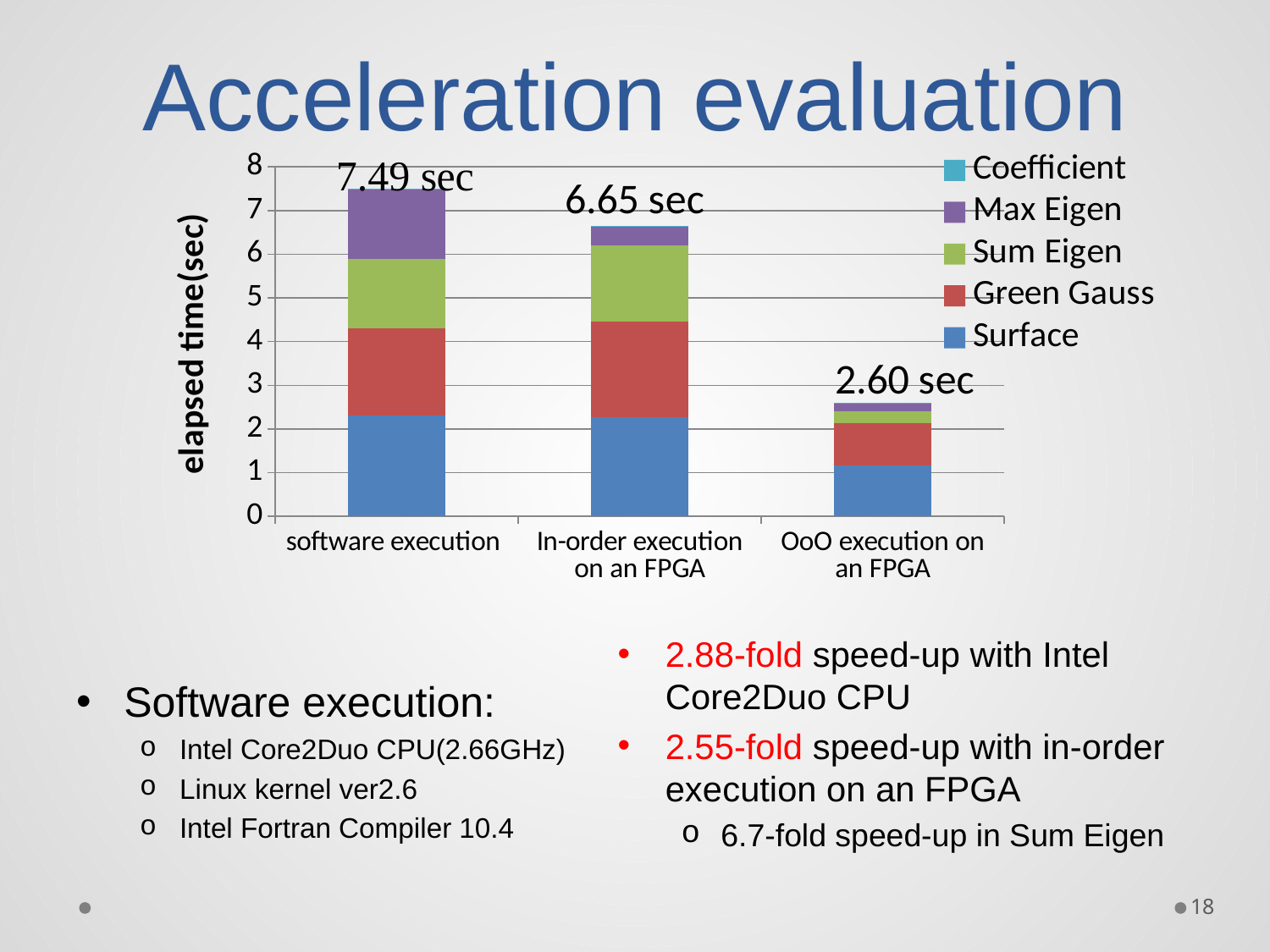
What is the total elapsed time for In-order execution on an FPGA? 6.65 sec What is the difference in total elapsed time between software execution and OoO execution on an FPGA? 4.89 sec What is the total elapsed time for OoO execution on an FPGA? 2.60 sec What kind of chart is shown on the slide? stacked bar chart Which execution method has the highest total elapsed time? software execution Which execution method has the lowest total elapsed time? OoO execution on an FPGA How many series does the legend list? 5 Is the Surface value for OoO execution on an FPGA greater or less than 2? less How many execution methods are shown on the x axis? 3 What is the total elapsed time for software execution? 7.49 sec What is the difference in total elapsed time between software execution and In-order execution on an FPGA? 0.84 sec Which has a larger total elapsed time, In-order execution on an FPGA or OoO execution on an FPGA? In-order execution on an FPGA